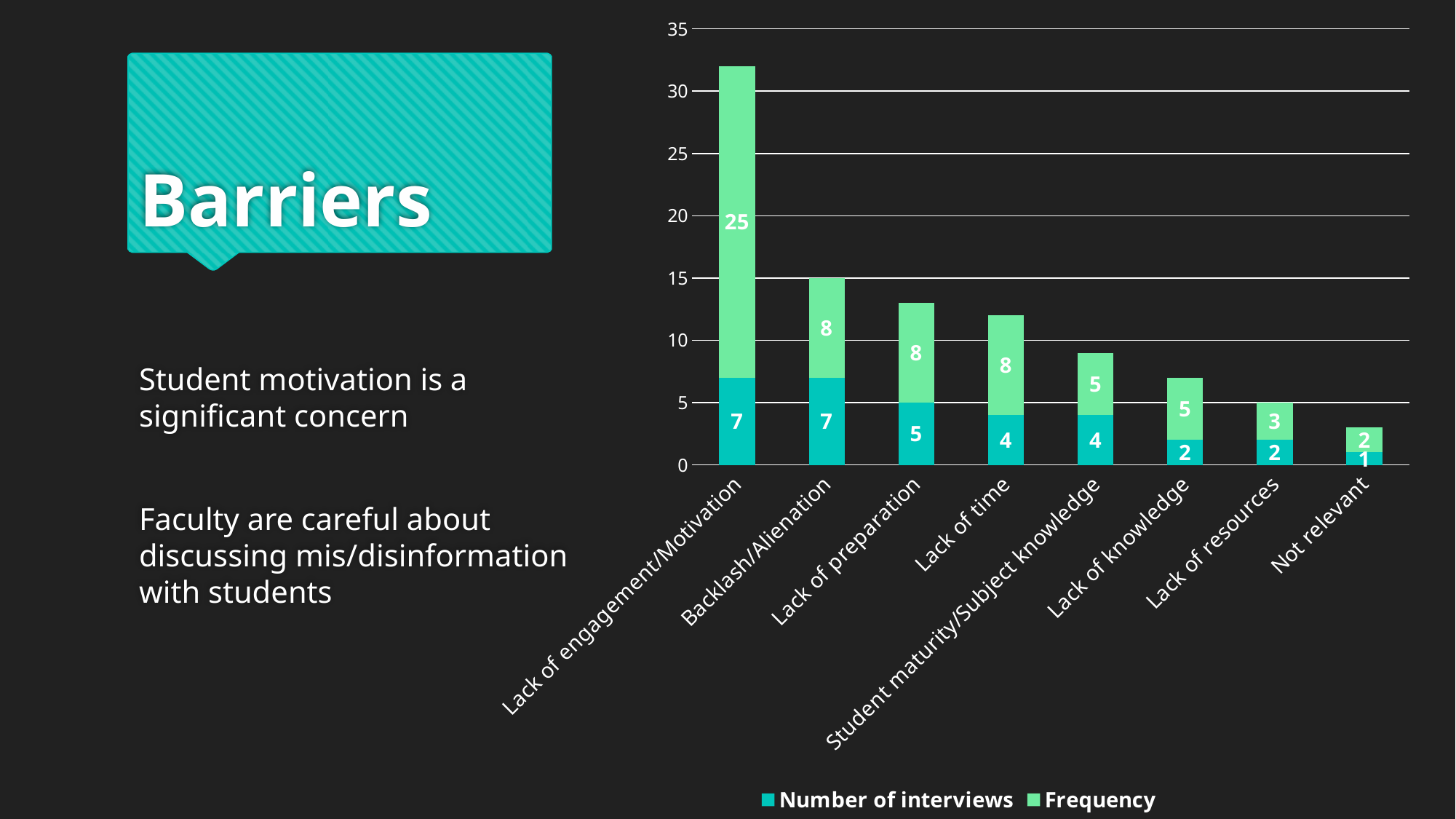
Which category has the lowest Number of interviews value? Not relevant What kind of chart is shown on the slide? Stacked bar chart What is the total of the stacked bar for Student maturity/Subject knowledge? 9 Which category has the highest Frequency value? Lack of engagement/Motivation What is the Frequency value for Lack of resources? 3 What is the total of the stacked bar for Lack of time? 12 How many series does the legend list? 2 What is the difference between the Frequency values for Lack of engagement/Motivation and Backlash/Alienation? 17 What is the Number of interviews value for Lack of preparation? 5 What is the Frequency value for Lack of engagement/Motivation? 25 Which is larger: the Number of interviews for Lack of time or for Lack of knowledge? Lack of time How many categories are shown on the x axis? 8